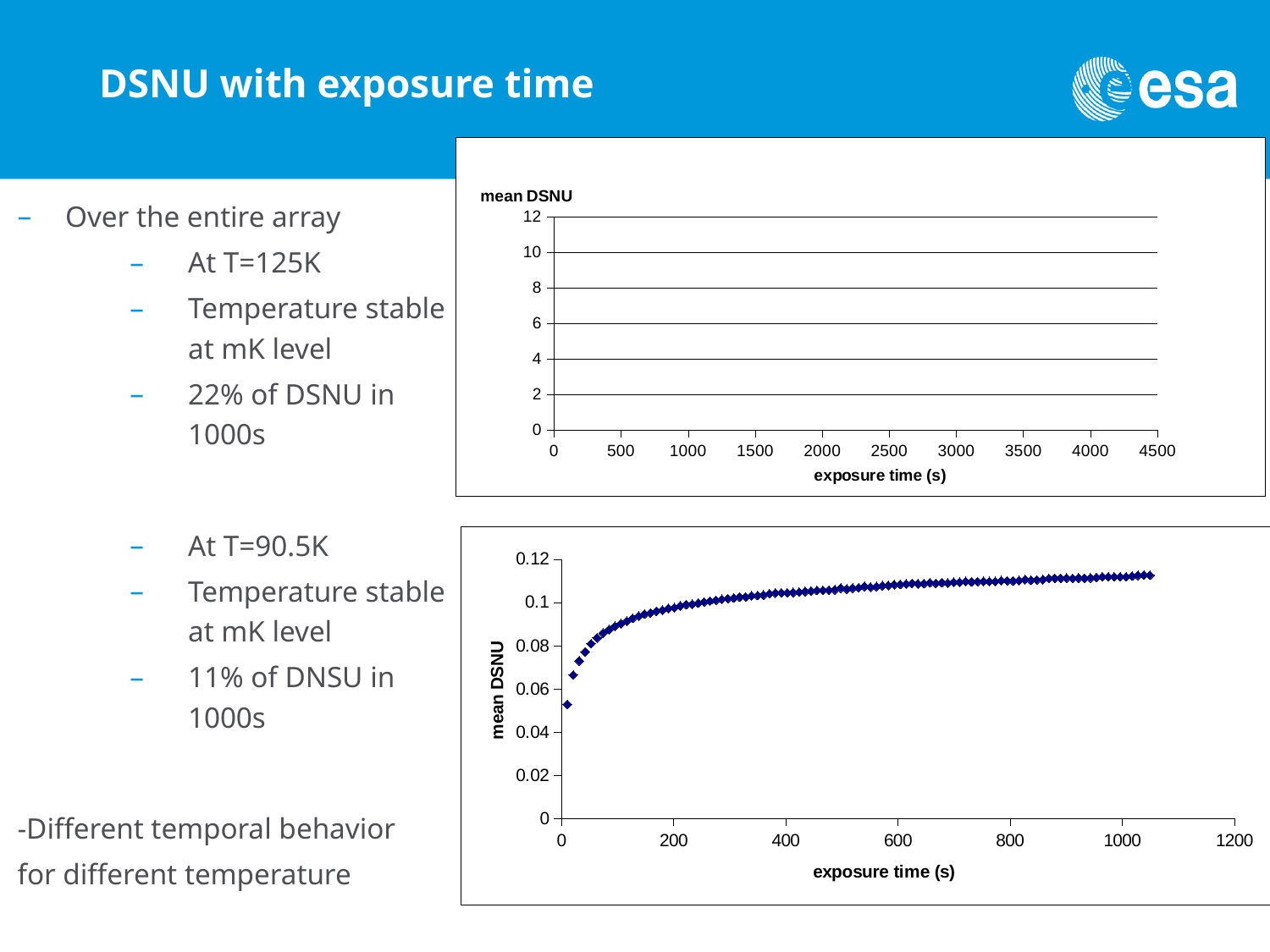
In the bottom chart, is the mean DSNU value at an exposure time of 200 s greater or less than 0.08? greater What kind of chart is the bottom chart on the slide? scatter chart In the bottom chart, which has the larger mean DSNU: the point at about 100 s or the point at about 1000 s? the point at about 1000 s In the bottom chart, is the mean DSNU value at an exposure time of 600 s greater or less than 0.12? less In the bottom chart, is the mean DSNU value at an exposure time of 1000 s greater or less than 0.1? greater What is the label of the x axis in the bottom chart? exposure time (s) In the bottom chart, do the mean DSNU values rise or fall as exposure time increases? rise What is the title of the top chart? mean DSNU